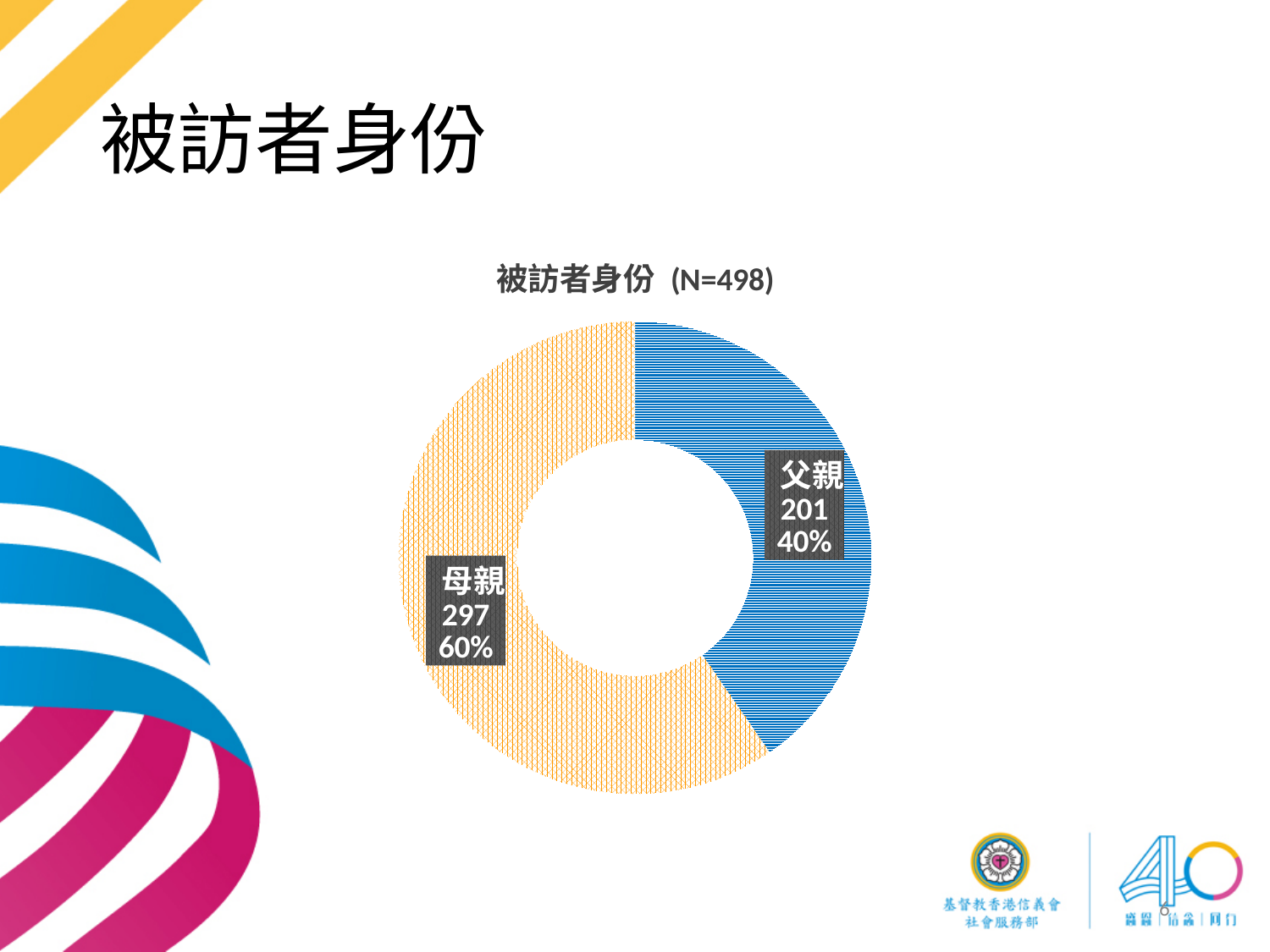
What is the difference in count between 母親 and 父親? 96 What is the total number of respondents (N) stated in the chart title? 498 How many categories does the chart show? 2 Is the count for 母親 larger or smaller than the count for 父親? larger What is the count for 父親 in the chart? 201 What is the title of the chart? 被訪者身份 (N=498) Which category has the larger share of respondents? 母親 What is the count for 母親 in the chart? 297 What kind of chart is shown on the slide? Doughnut (pie) chart What percentage of respondents are 母親? 60% Which category has the smaller share of respondents? 父親 What percentage of respondents are 父親? 40%